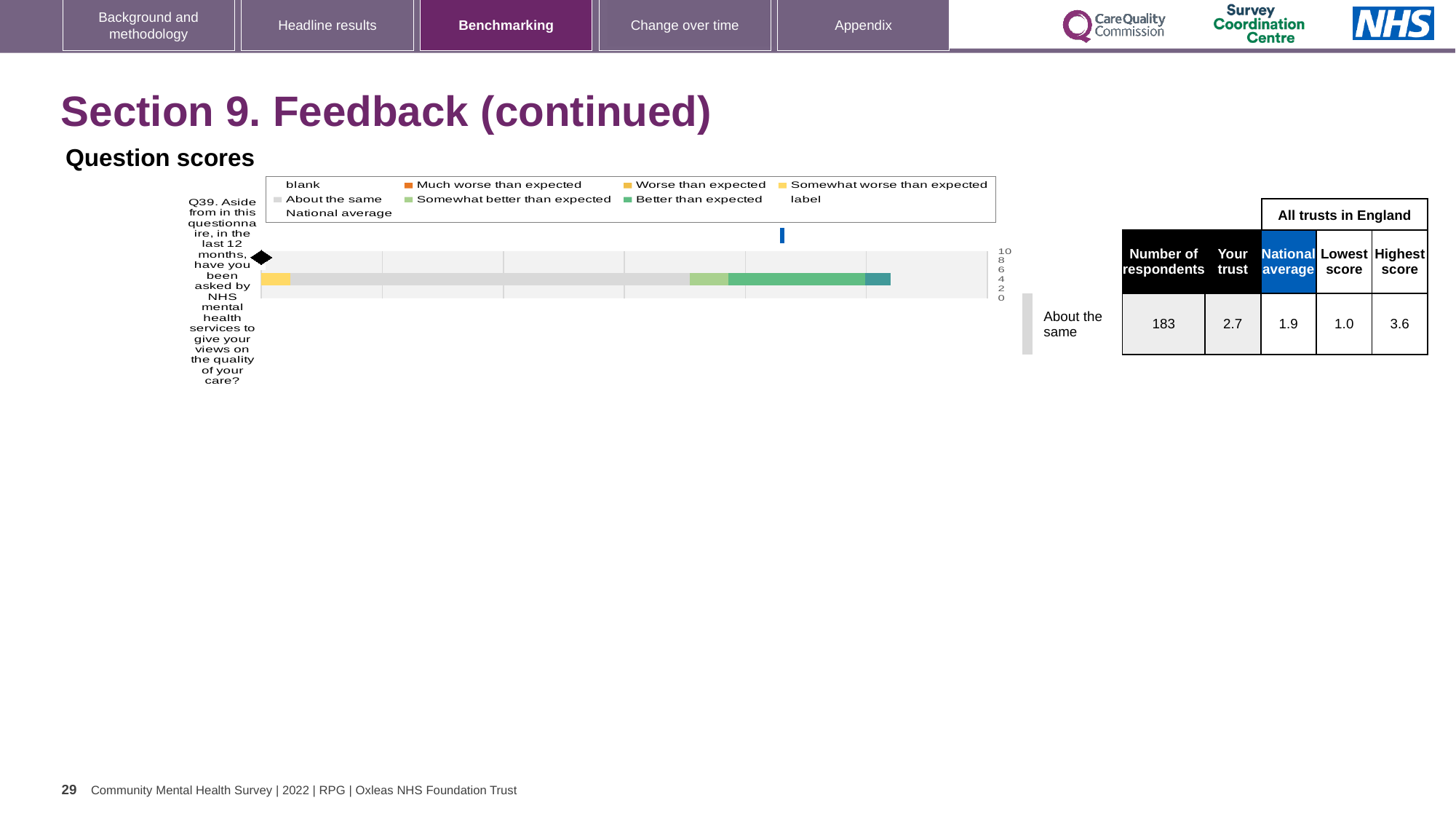
Which question is plotted in the 'Question scores' chart? Q39 In the legend of the 'Question scores' chart, what colour represents 'Much worse than expected'? orange In the table beside the 'Question scores' chart, what is the 'Your trust' score for Q39? 2.7 What kind of chart is shown under 'Question scores'? bar chart In the table beside the 'Question scores' chart, what is the lowest score among all trusts in England for Q39? 1.0 According to the table beside the 'Question scores' chart, what is the difference between the 'Your trust' score and the national average for Q39? 0.8 In the table beside the 'Question scores' chart, what is the number of respondents for Q39? 183 According to the table beside the 'Question scores' chart, is the 'Your trust' score for Q39 larger or smaller than the national average? larger How many questions (categories) are plotted in the 'Question scores' chart? 1 In the table beside the 'Question scores' chart, what is the national average for Q39? 1.9 In the table beside the 'Question scores' chart, what is the highest score among all trusts in England for Q39? 3.6 How many entries does the legend of the 'Question scores' chart list? 9